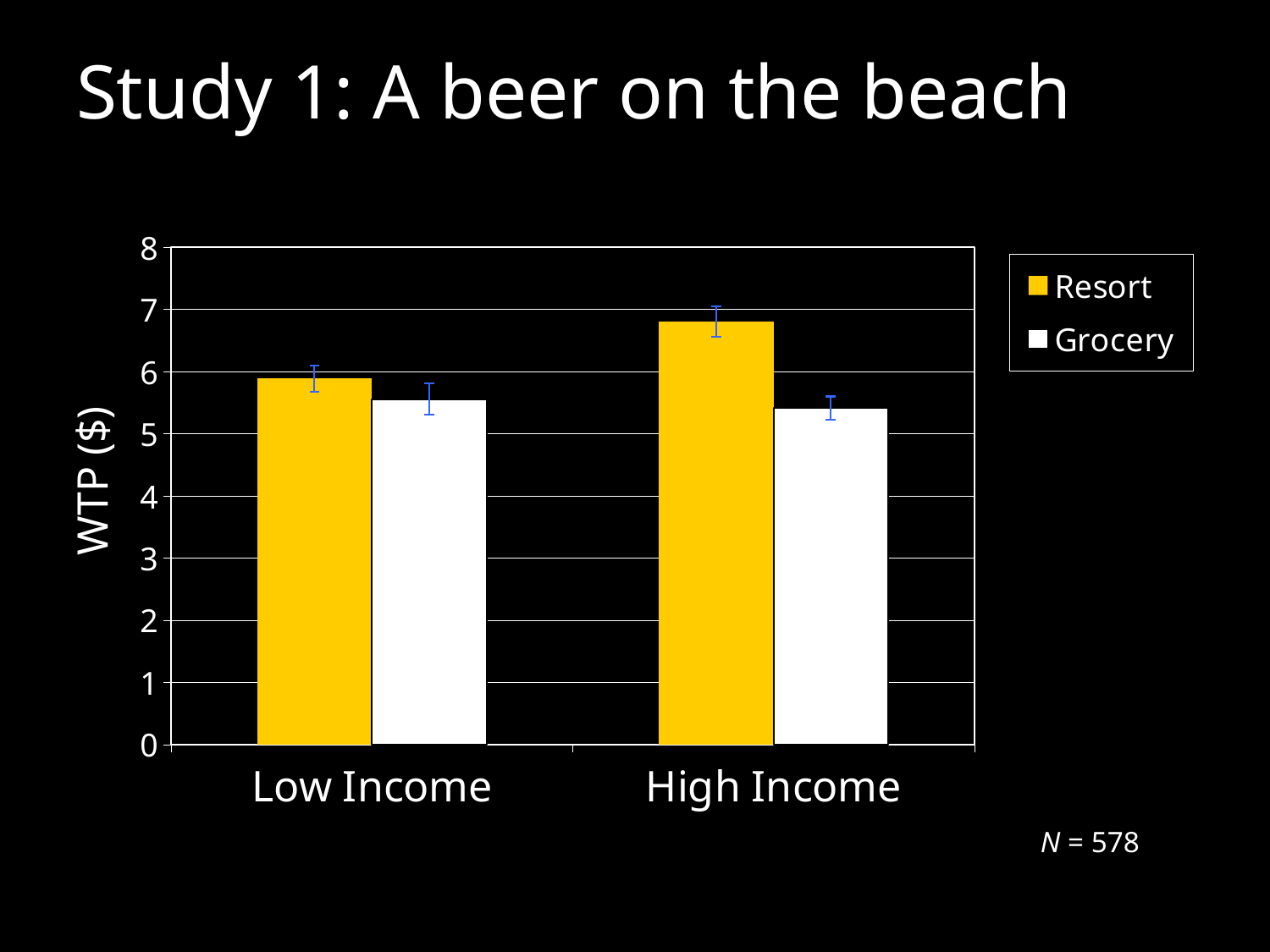
What is the label on the y axis? WTP ($) Is the Grocery value for Low Income greater or less than 5? greater Does the Resort value rise or fall from Low Income to High Income? rise Which colour represents the Resort series in the legend? yellow Is the Resort value for High Income greater or less than 7? less Which bar is the highest in the chart? Resort, High Income Is the Grocery value for High Income greater or less than 6? less What kind of chart is shown on the slide? bar chart For High Income, which is larger: Resort or Grocery? Resort How many series does the legend list? 2 How many income categories are shown on the x axis? 2